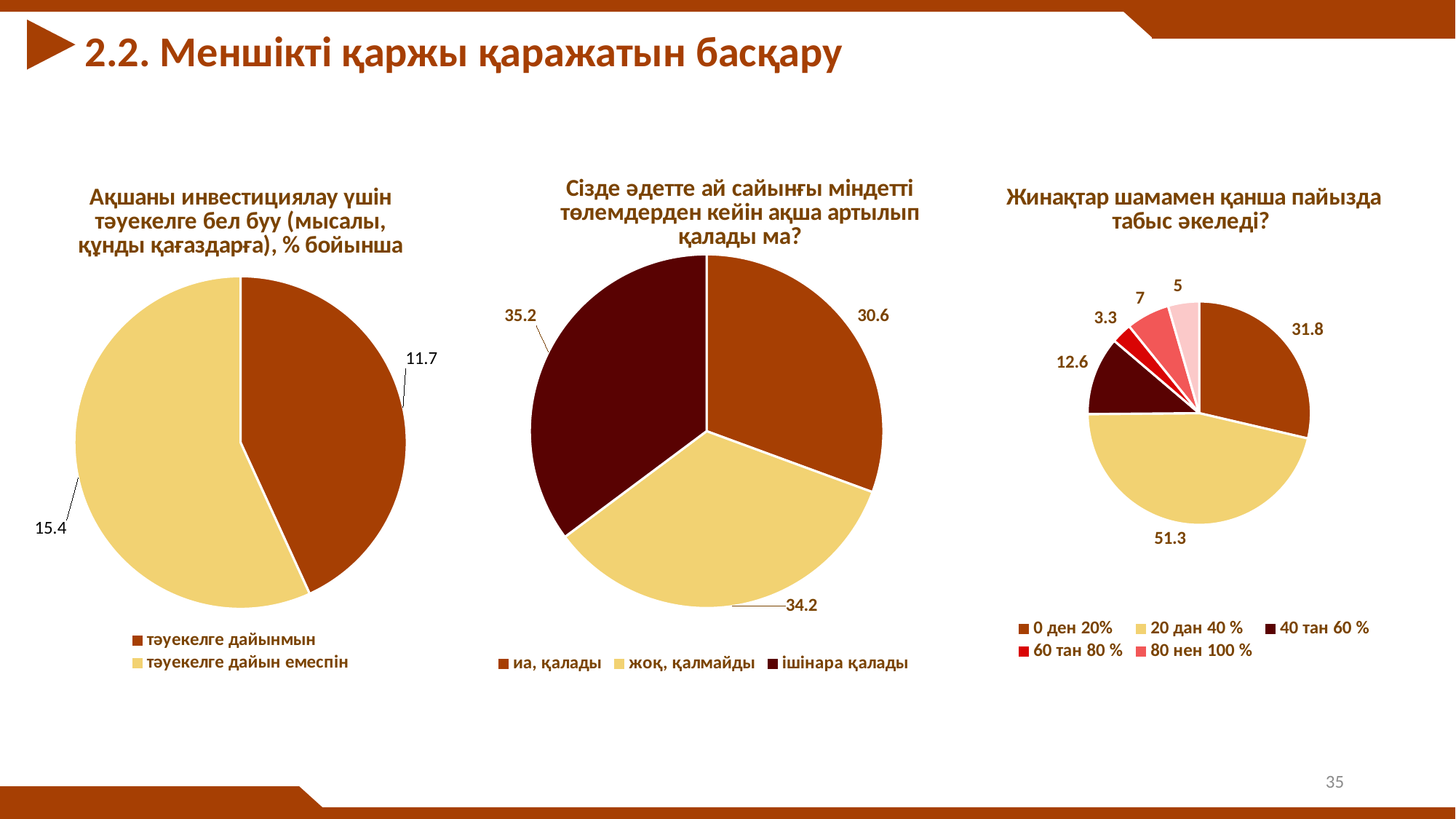
In the left chart titled "Ақшаны инвестициялау үшін тәуекелге бел буу", what is the value for "тәуекелге дайын емеспін"? 15.4 In the middle chart titled "Сізде әдетте ай сайынғы міндетті төлемдерден кейін ақша артылып қалады ма?", what is the value for "ішінара қалады"? 35.2 In the middle chart titled "Сізде әдетте ай сайынғы міндетті төлемдерден кейін ақша артылып қалады ма?", what is the value for "иа, қалады"? 30.6 In the middle chart titled "Сізде әдетте ай сайынғы міндетті төлемдерден кейін ақша артылып қалады ма?", which category has the smallest value? иа, қалады In the right chart titled "Жинақтар шамамен қанша пайызда табыс әкеледі?", what is the value for "20 дан 40 %"? 51.3 In the middle chart titled "Сізде әдетте ай сайынғы міндетті төлемдерден кейін ақша артылып қалады ма?", how many categories does the legend list? 3 What kind of chart is the middle chart titled "Сізде әдетте ай сайынғы міндетті төлемдерден кейін ақша артылып қалады ма?"? pie chart In the left chart titled "Ақшаны инвестициялау үшін тәуекелге бел буу", what is the difference between the two values? 3.7 In the left chart titled "Ақшаны инвестициялау үшін тәуекелге бел буу", which category has the larger slice? тәуекелге дайын емеспін In the right chart titled "Жинақтар шамамен қанша пайызда табыс әкеледі?", which is larger, "0 ден 20%" or "40 тан 60 %"? 0 ден 20% In the right chart titled "Жинақтар шамамен қанша пайызда табыс әкеледі?", what is the value for "60 тан 80 %"? 3.3 In the left chart titled "Ақшаны инвестициялау үшін тәуекелге бел буу", what is the value for "тәуекелге дайынмын"? 11.7